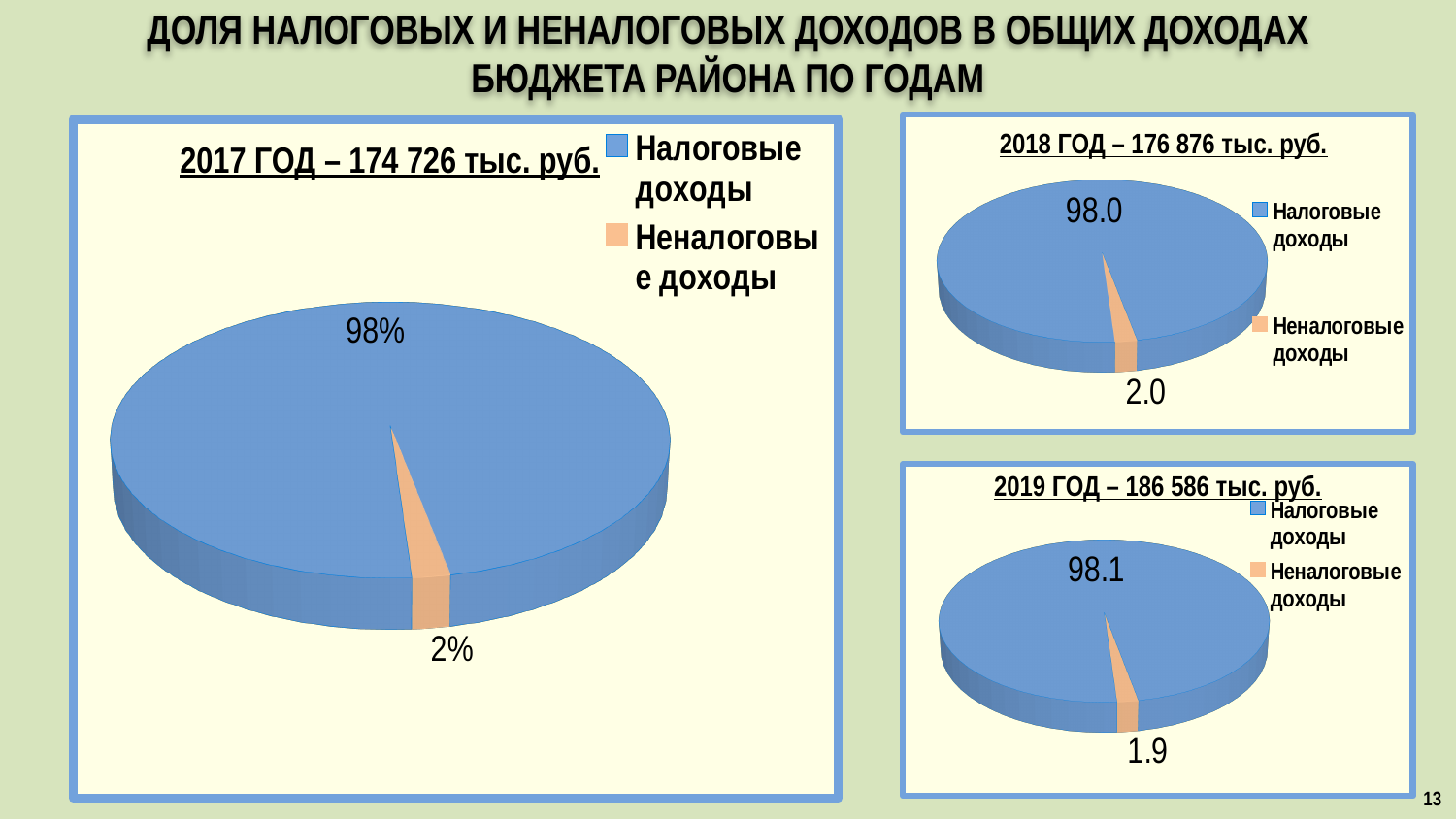
How many categories does the 2017 chart (2017 ГОД – 174 726 тыс. руб.) show? 2 In the 2018 chart (2018 ГОД – 176 876 тыс. руб.), what is the value for Налоговые доходы? 98.0 What kind of chart is the 2018 chart (2018 ГОД – 176 876 тыс. руб.)? Pie chart In the 2017 chart, which category has the largest slice? Налоговые доходы In the 2019 chart, what is the difference between the values for Налоговые доходы and Неналоговые доходы? 96.2 In the 2017 chart (2017 ГОД – 174 726 тыс. руб.), what is the value for Неналоговые доходы? 2% In the 2018 chart (2018 ГОД – 176 876 тыс. руб.), what is the value for Неналоговые доходы? 2.0 In the 2019 chart (2019 ГОД – 186 586 тыс. руб.), what is the value for Налоговые доходы? 98.1 In the 2019 chart (2019 ГОД – 186 586 тыс. руб.), what is the value for Неналоговые доходы? 1.9 In the 2019 chart, which category has the smallest slice? Неналоговые доходы In the 2017 chart (2017 ГОД – 174 726 тыс. руб.), what is the value for Налоговые доходы? 98% How many charts are on the slide? 3